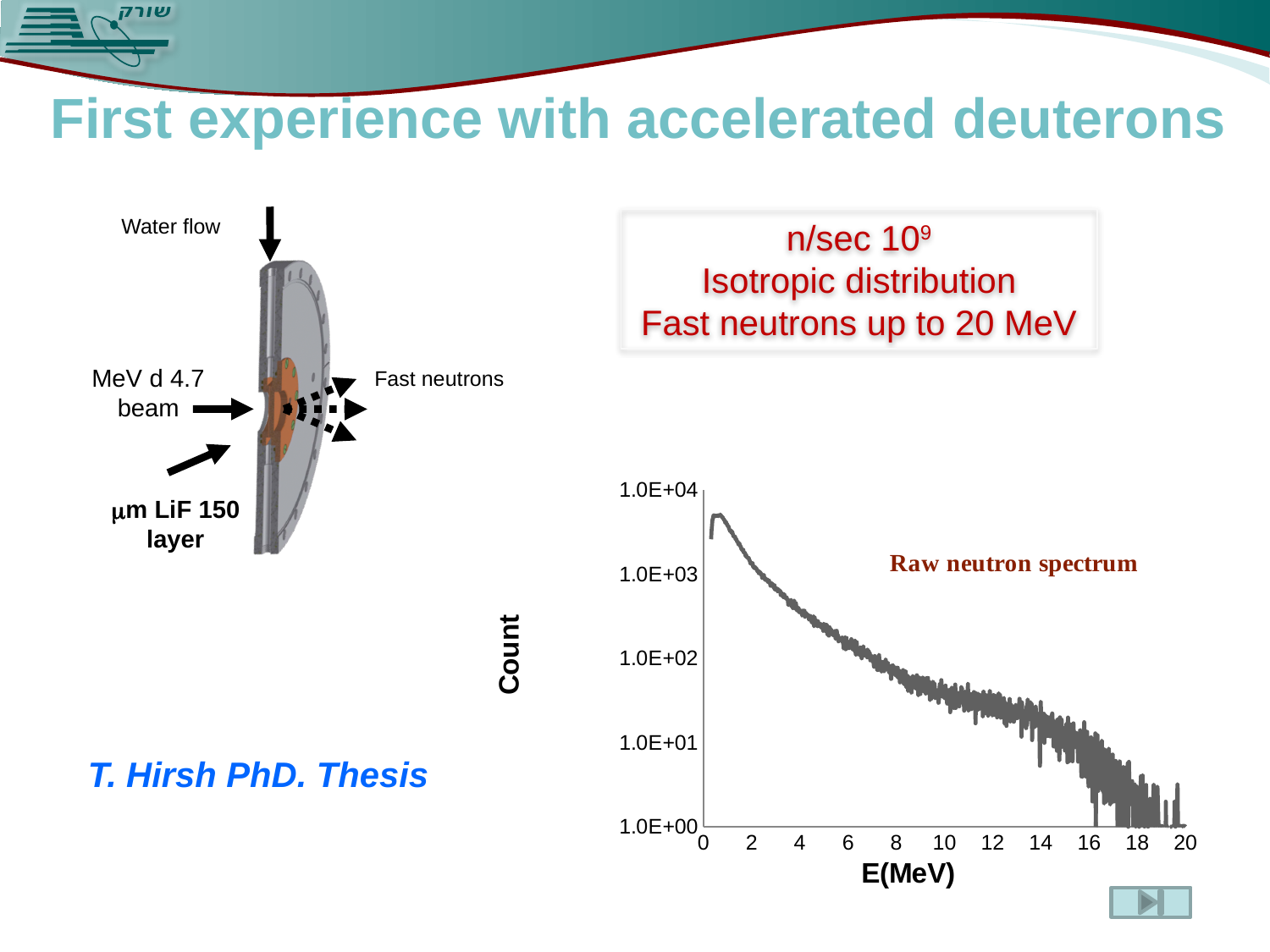
In the 'Raw neutron spectrum' chart, is the peak count near 1 MeV greater or less than 1.0E+04? less In the 'Raw neutron spectrum' chart, which has the higher count: 2 MeV or 12 MeV? 2 MeV In the 'Raw neutron spectrum' chart, do the counts rise or fall as E(MeV) increases from 2 to 18? fall What is the label of the y axis of the chart on the slide? Count In the 'Raw neutron spectrum' chart, is the count at 4 MeV greater or less than 1.0E+02? greater What is the label of the x axis of the chart on the slide? E(MeV) In the 'Raw neutron spectrum' chart, is the count at 18 MeV greater or less than 1.0E+01? less What kind of chart is the 'Raw neutron spectrum' chart? line chart How many tick labels are shown on the y axis of the 'Raw neutron spectrum' chart? 5 How many tick labels are shown on the x axis of the 'Raw neutron spectrum' chart? 11